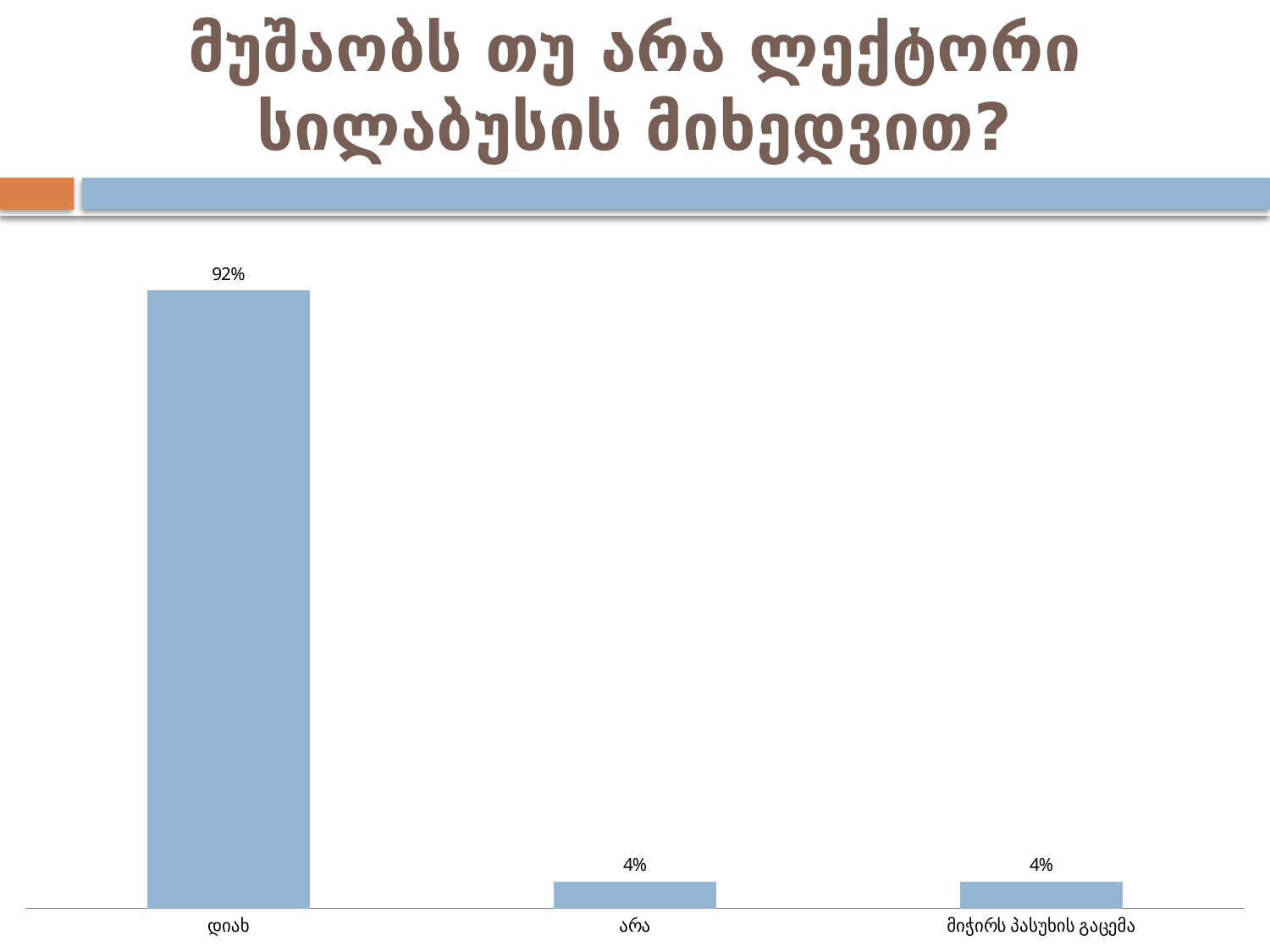
Which is larger, the value for დიახ or the value for მიჭირს პასუხის გაცემა? დიახ What is the difference between the values for დიახ and არა? 88% What kind of chart is shown on the slide? bar chart What is the value for არა? 4% How many categories are shown on the chart? 3 What colour are the bars on the chart? light blue What is the total of the values for არა and მიჭირს პასუხის გაცემა? 8% Do the values for არა and მიჭირს პასუხის გაცემა differ? No, both are 4% What is the value for მიჭირს პასუხის გაცემა? 4% Which category has the highest value? დიახ What is the value for დიახ? 92% What is the title of the slide? მუშაობს თუ არა ლექტორი სილაბუსის მიხედვით?